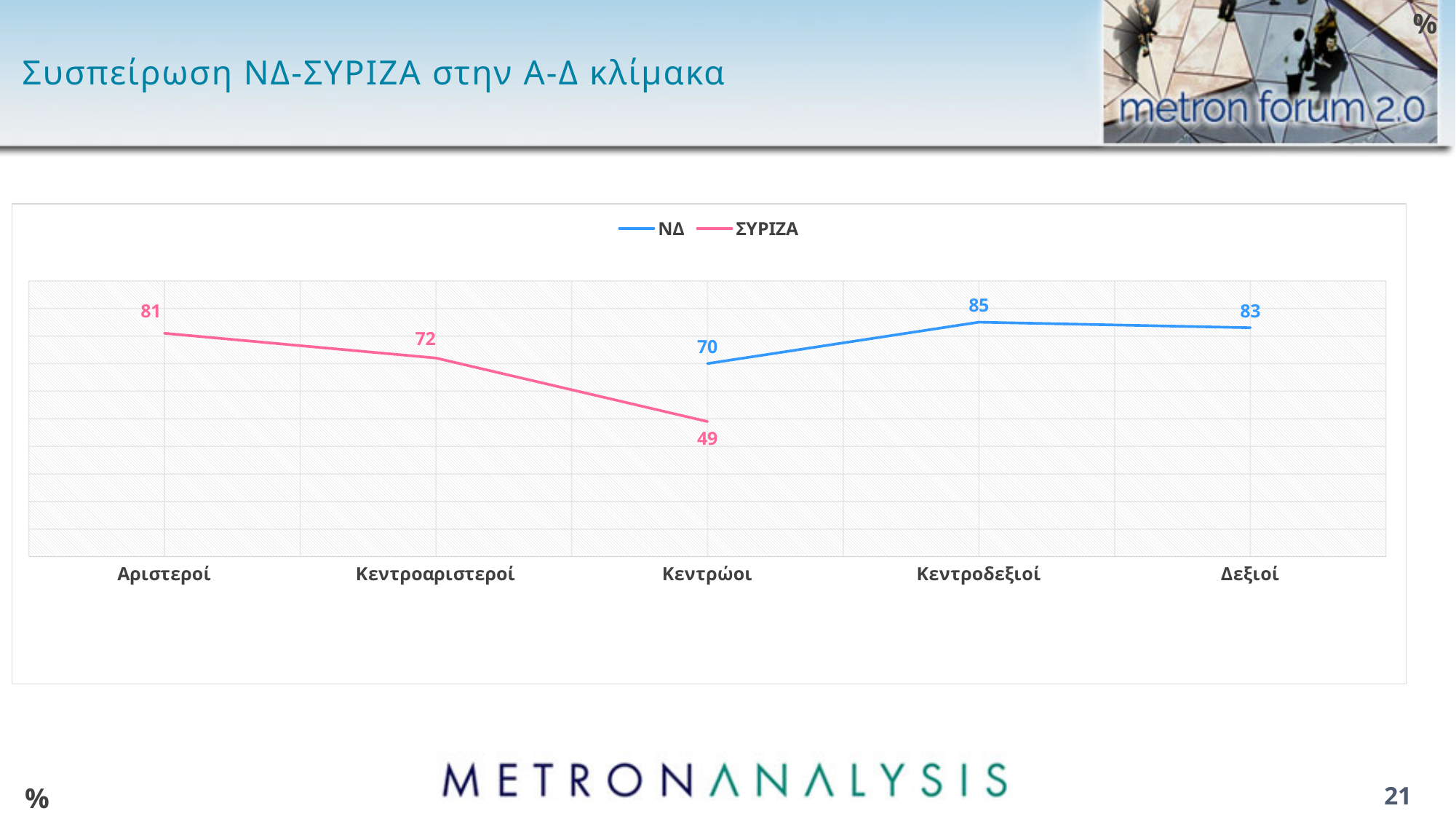
For which category is the ΝΔ value highest? Κεντροδεξιοί What is the ΝΔ value for Κεντροδεξιοί? 85 How many series does the legend list? 2 What is the ΣΥΡΙΖΑ value for Κεντροαριστεροί? 72 What is the ΣΥΡΙΖΑ value for Αριστεροί? 81 What is the ΝΔ value for Κεντρώοι? 70 What is the difference between the ΝΔ and ΣΥΡΙΖΑ values for Κεντρώοι? 21 What is the ΣΥΡΙΖΑ value for Κεντρώοι? 49 What is the ΝΔ value for Δεξιοί? 83 What kind of chart is shown on the slide? Line chart Which is larger: the ΣΥΡΙΖΑ value for Αριστεροί or the ΝΔ value for Δεξιοί? ΝΔ value for Δεξιοί For which category is the ΣΥΡΙΖΑ value lowest? Κεντρώοι